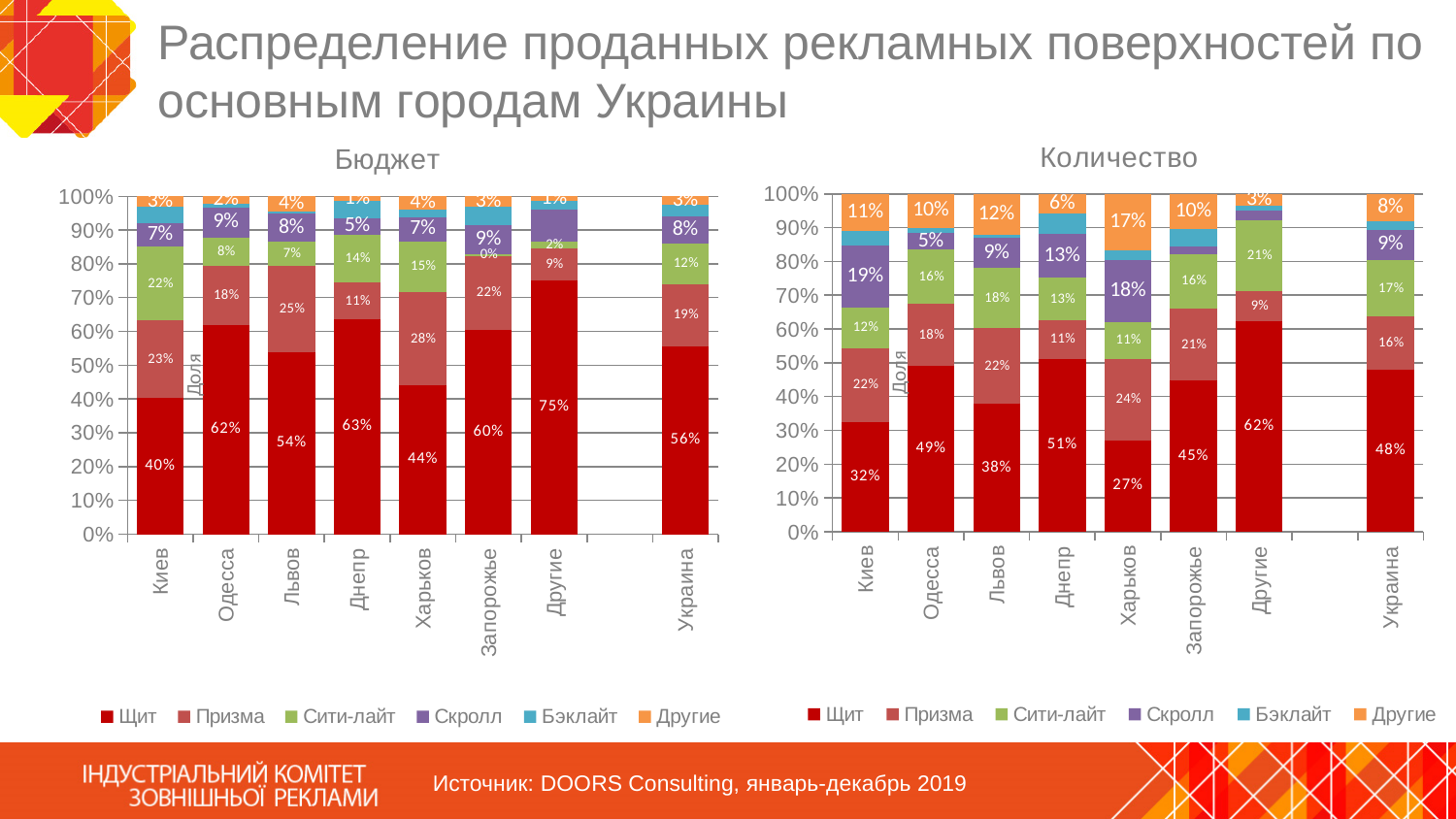
In the Количество chart, which is larger: the Щит share for Днепр or for Львов? Днепр In the Бюджет chart, what is the difference between the Щит share for Одесса and for Киев? 22 percentage points In the Бюджет chart, what is the value of Призма for Харьков? 28% In the Бюджет chart, what is the value of Щит for Киев? 40% In the Количество chart, what is the value of Скролл for Киев? 19% What is the title of the chart on the right side of the slide? Количество In the Количество chart, which category has the lowest Щит share? Харьков How many series does the legend of the Количество chart list? 6 How many categories are shown on the x axis of the Бюджет chart? 8 In the Бюджет chart, which category has the highest Щит share? Другие In the Количество chart, what is the value of Щит for Харьков? 27% What kind of chart is the Бюджет chart? Stacked bar chart